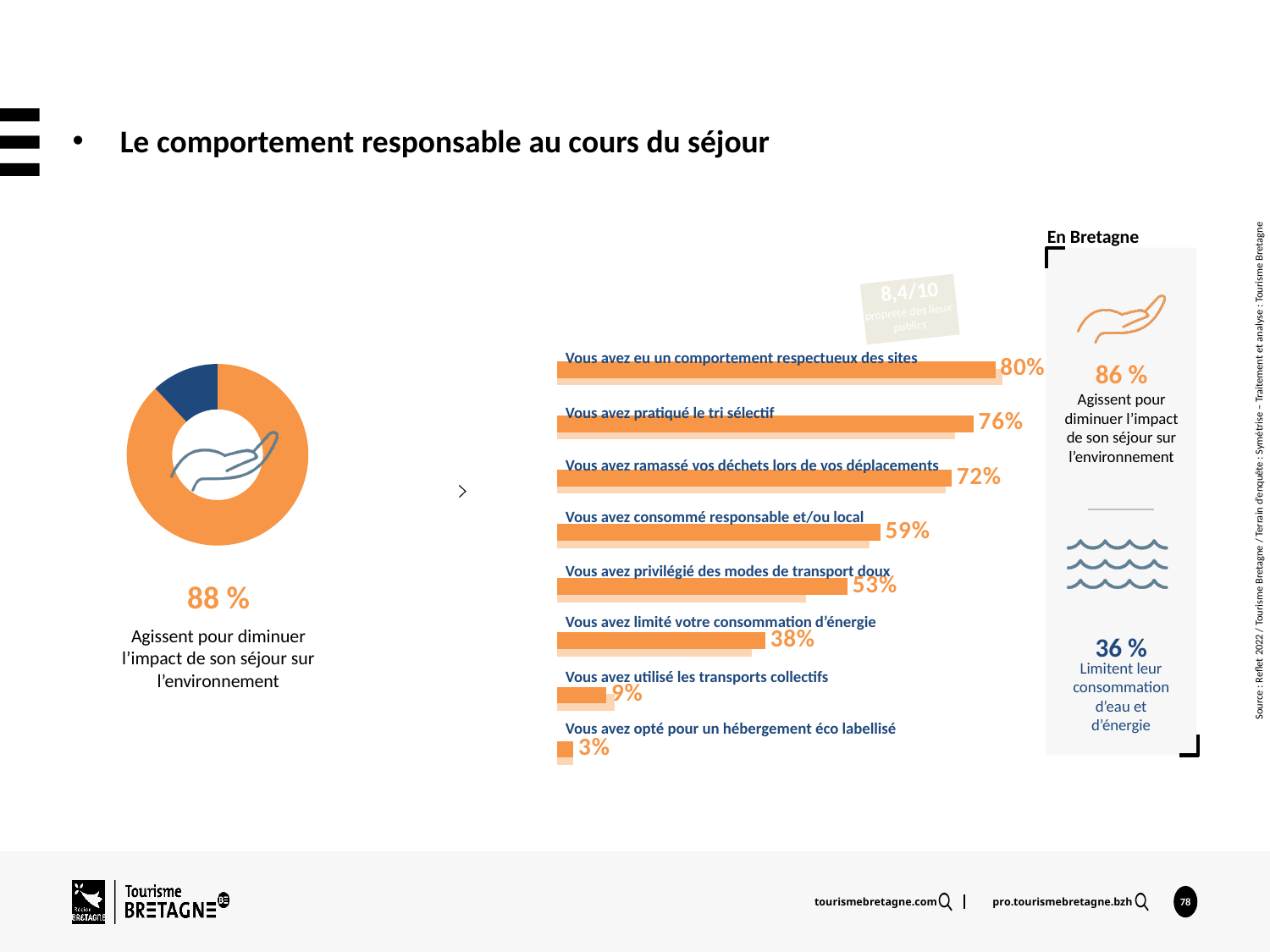
In the donut chart on the left, what percentage is printed for those who act to reduce the environmental impact of their stay? 88 % In the bar chart on the right, which category has the highest value? Vous avez eu un comportement respectueux des sites In the bar chart on the right, do the values increase or decrease from the top category to the bottom category? Decrease In the bar chart on the right, what is the difference between "Vous avez ramassé vos déchets lors de vos déplacements" and "Vous avez consommé responsable et/ou local"? 13% What kind of chart is shown on the right of the slide? Bar chart How many categories does the bar chart on the right show? 8 In the bar chart on the right, which category has the lowest value? Vous avez opté pour un hébergement éco labellisé In the bar chart on the right, what is the value for "Vous avez pratiqué le tri sélectif"? 76% In the bar chart on the right, what is the value for "Vous avez utilisé les transports collectifs"? 9% In the bar chart on the right, what is the value for "Vous avez privilégié des modes de transport doux"? 53% In the bar chart on the right, which is larger: "Vous avez limité votre consommation d'énergie" or "Vous avez privilégié des modes de transport doux"? Vous avez privilégié des modes de transport doux What kind of chart is shown on the left of the slide? Donut chart